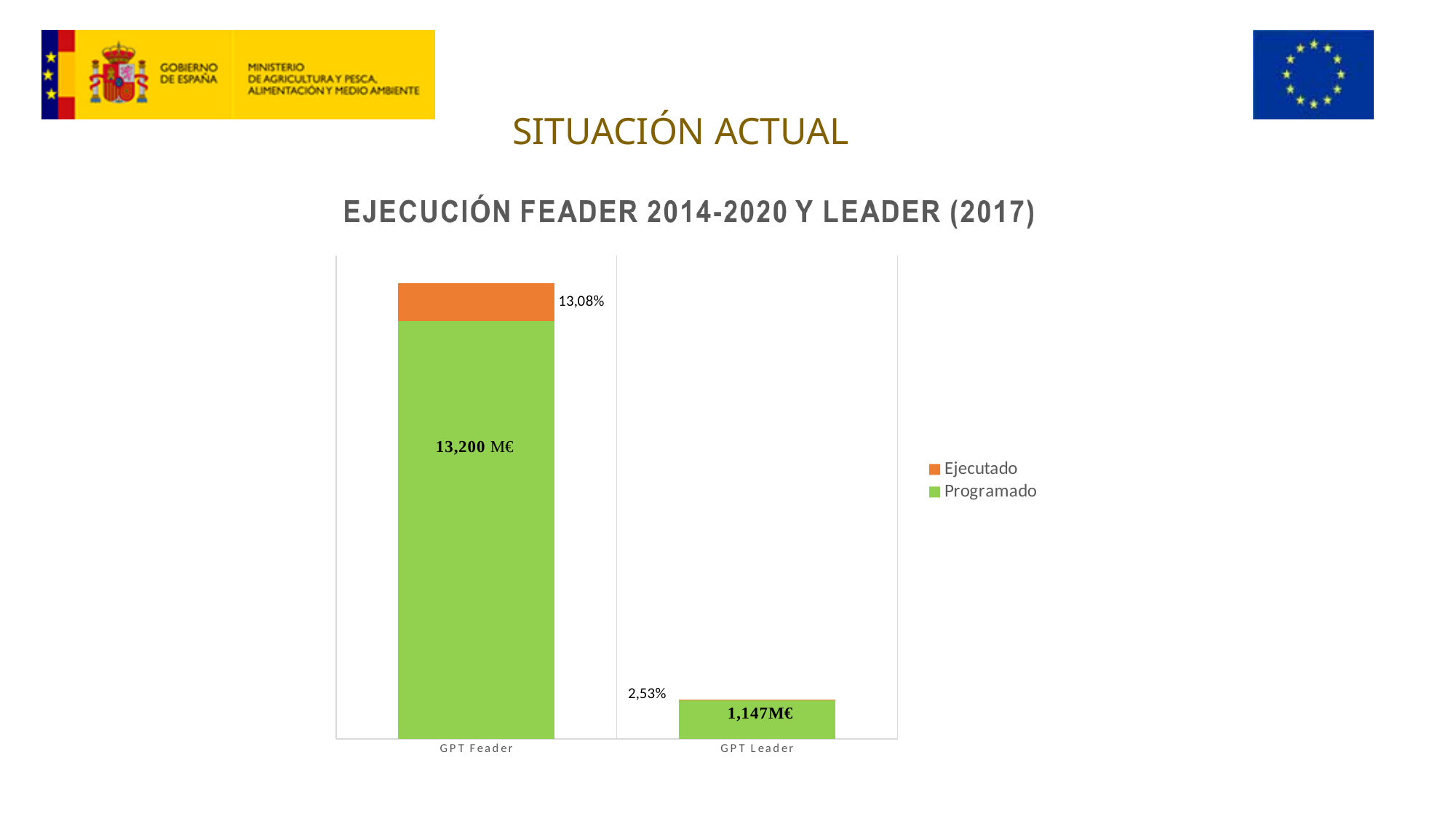
What is the Ejecutado label shown for GPT Leader? 2,53% Which category has the higher Programado value? GPT Feader How many categories are shown on the x axis? 2 Which category has the lower Programado value? GPT Leader Is the Ejecutado percentage for GPT Feader larger or smaller than that for GPT Leader? larger How many series does the legend list? 2 What kind of chart is shown on the slide? stacked bar chart Which series is shown in orange in the legend? Ejecutado What is the title of the chart? EJECUCIÓN FEADER 2014-2020 Y LEADER (2017) What is the Ejecutado label shown for GPT Feader? 13,08%